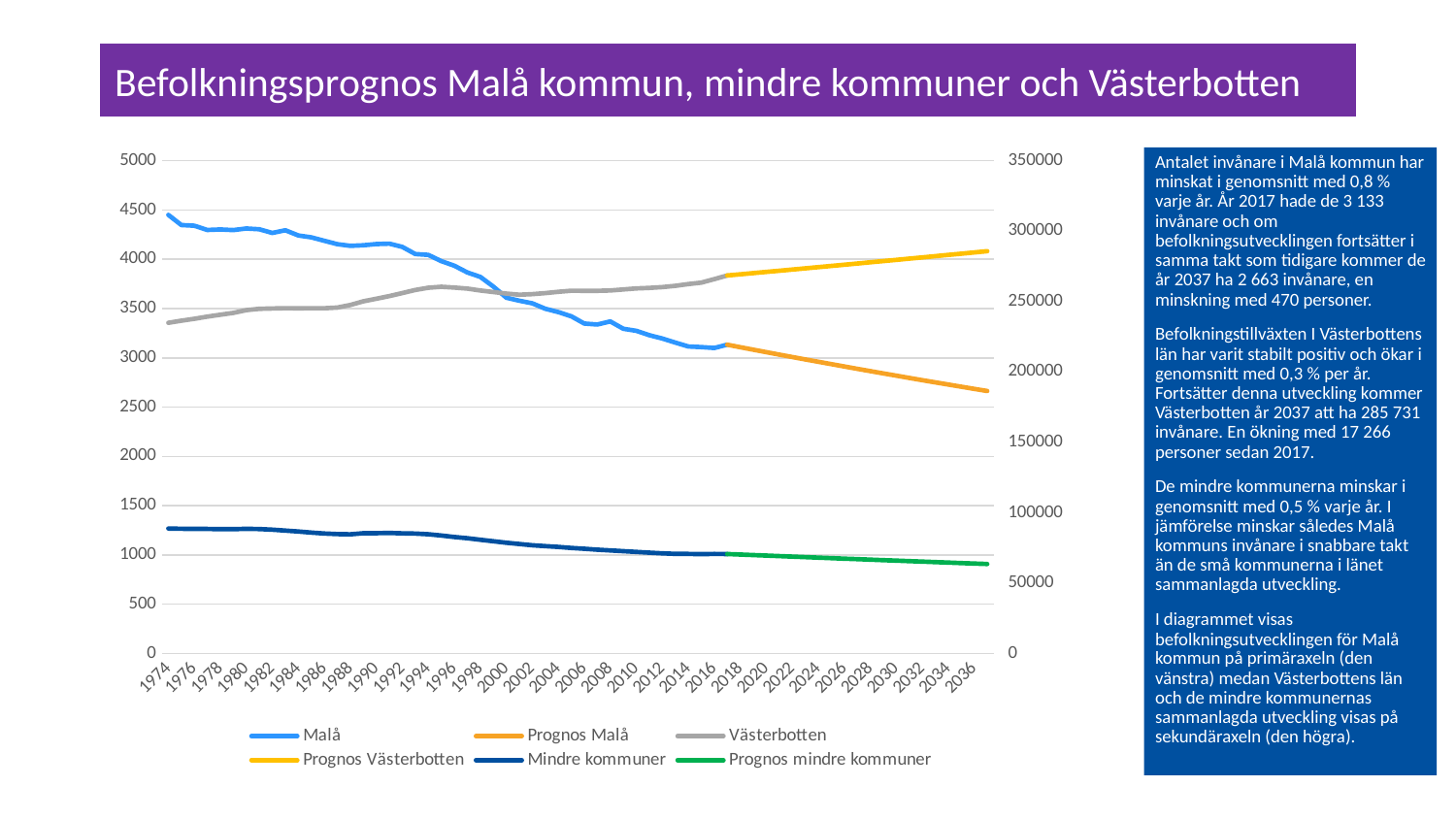
Does the Mindre kommuner series rise or fall from 1974 to 2016? fall Which series is drawn in green in the chart? Prognos mindre kommuner Is the value for Malå in 1974 greater or less than 4000? greater How many series does the legend list? 6 Does the Malå series rise or fall from 1974 to 2016? fall What kind of chart is shown on the slide? line chart Is the value for Mindre kommuner in 1974 greater or less than 1500? greater What is the title of the chart on the slide? Befolkningsprognos Malå kommun, mindre kommuner och Västerbotten Does the Västerbotten series rise or fall from 1974 to 2016? rise Is the value for Prognos Malå in 2036 greater or less than 3000? less